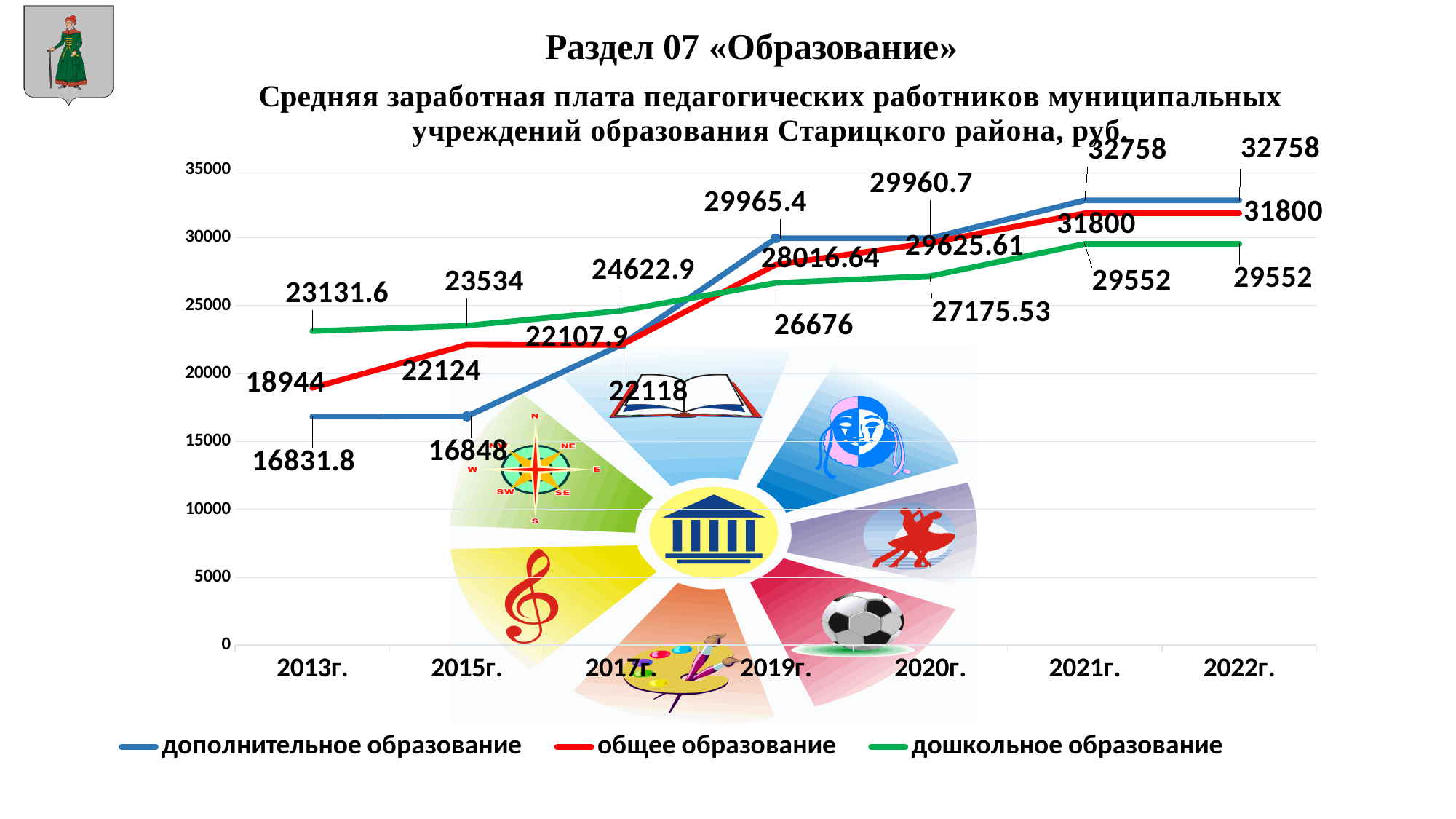
Which series has the highest value in 2013г.? дошкольное образование What is the value for дошкольное образование in 2017г.? 24622.9 What is the difference between дошкольное образование and дополнительное образование in 2013г.? 6299.8 What is the difference between дополнительное образование and общее образование in 2022г.? 958 What is the value for общее образование in 2013г.? 18944 How many years are shown on the x axis? 7 What kind of chart is shown on the slide? line chart In 2019г., which is larger: дополнительное образование or общее образование? дополнительное образование What is the value for дополнительное образование in 2019г.? 29965.4 In which year is the value for общее образование lowest? 2013г. How many series does the legend list? 3 What is the value for дошкольное образование in 2020г.? 27175.53